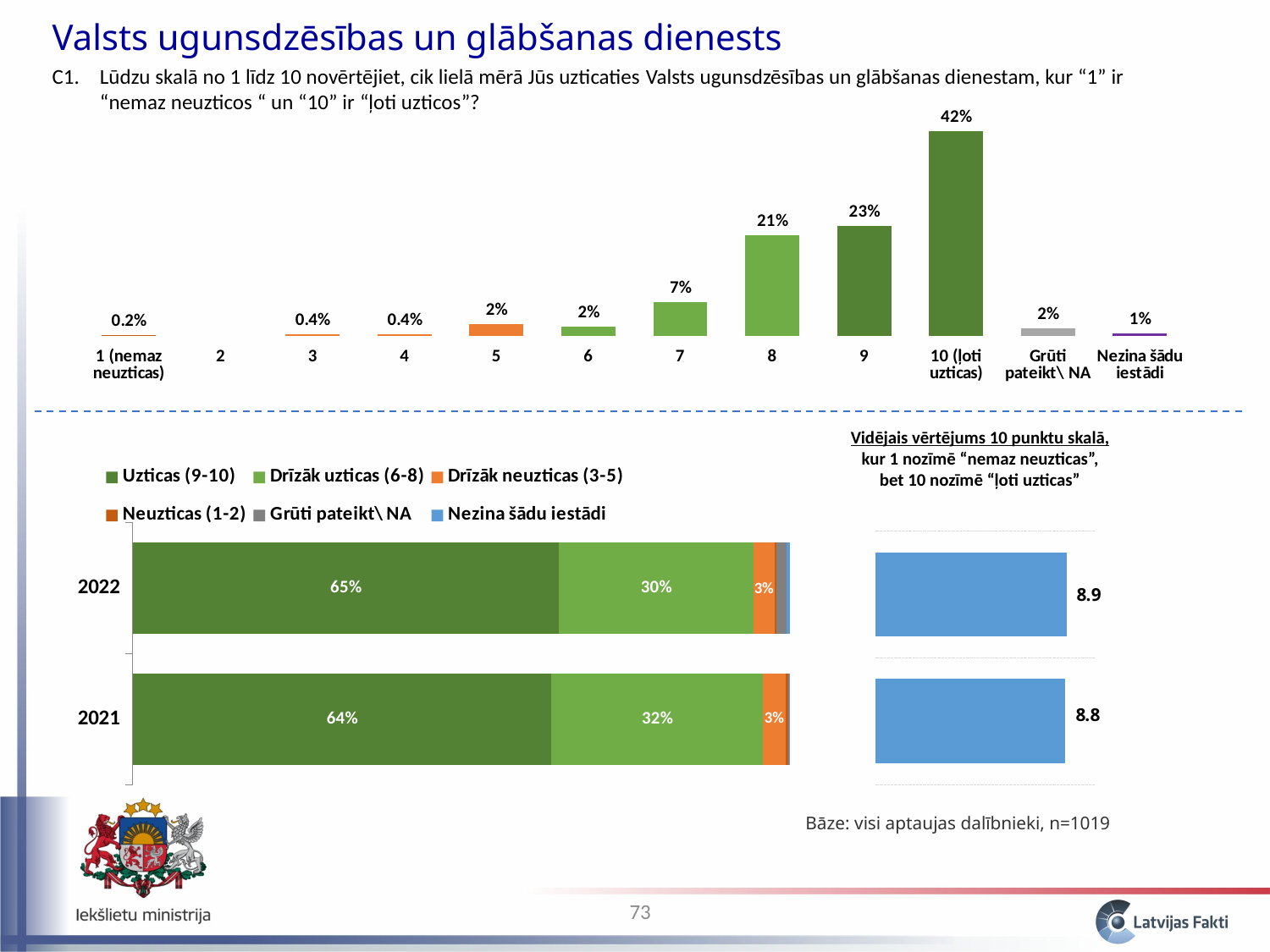
In the top bar chart, what is the value for "10 (ļoti uzticas)"? 42% How many series does the legend of the stacked bar chart at the bottom left list? 6 In the stacked bar chart at the bottom left, what is the value of "Uzticas (9-10)" for 2022? 65% What kind of chart is the top chart on the slide? Bar chart In the top bar chart, which has the larger value, category 7 or category 6? 7 In the top bar chart, what is the difference between the values for category 9 and category 8? 2 percentage points In the top bar chart, which category has the highest value? 10 (ļoti uzticas) In the stacked bar chart at the bottom left, what is the value of "Drīzāk uzticas (6-8)" for 2021? 32% In the "Vidējais vērtējums 10 punktu skalā" chart at the bottom right, which year has the higher value, 2022 or 2021? 2022 In the top bar chart, what is the value for category 8? 21% In the "Vidējais vērtējums 10 punktu skalā" chart at the bottom right, what is the value for 2022? 8.9 In the top bar chart, what is the value for "Grūti pateikt\ NA"? 2%